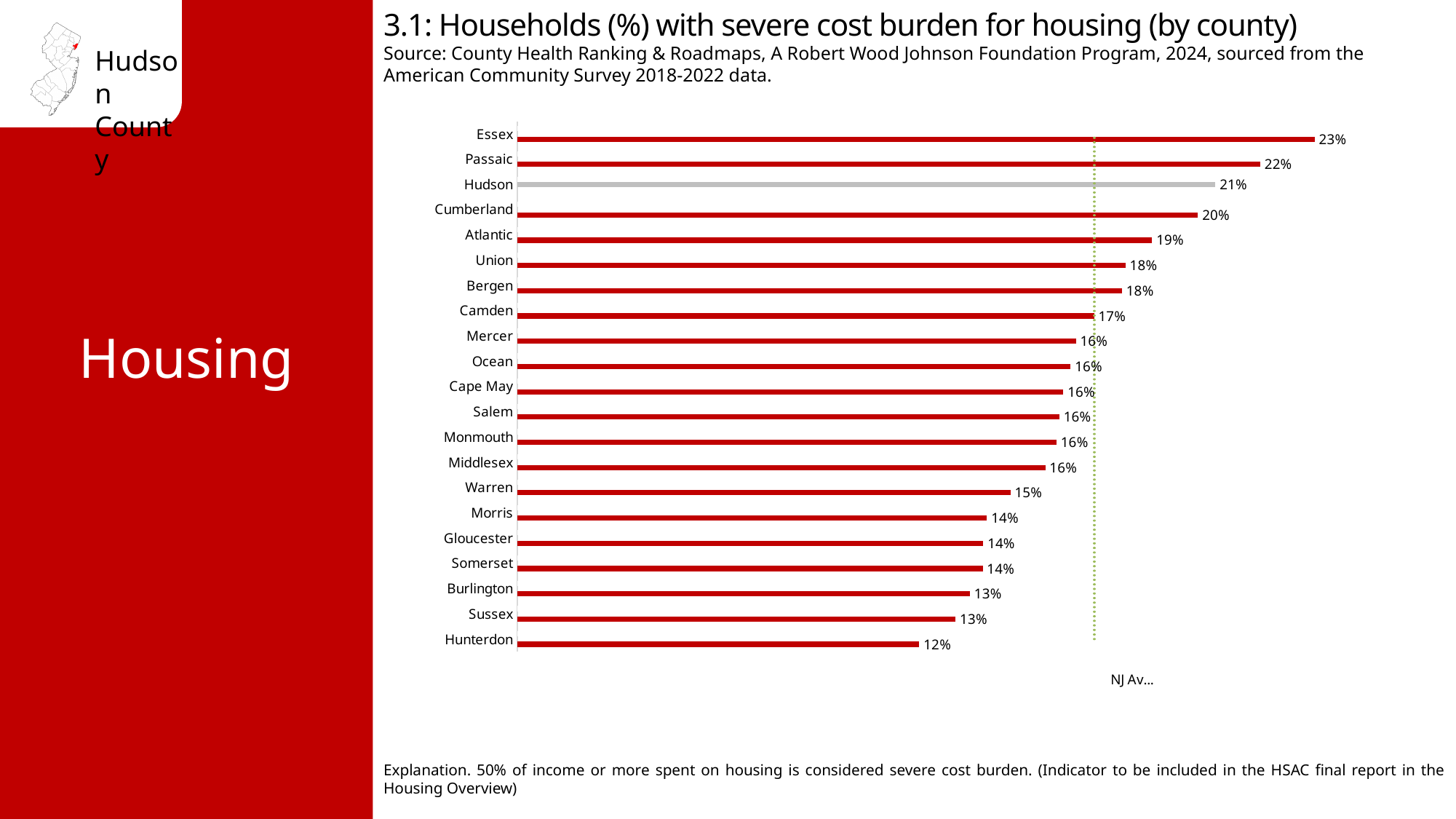
What is the difference between the values for Essex and Hunterdon? 11% Which county has the highest value? Essex Which is larger, the value for Passaic or the value for Atlantic? Passaic What is the difference between the values for Hudson and Warren? 6% Which county has the lowest value? Hunterdon What is the value for Hunterdon? 12% Which county's bar is shown in grey rather than red? Hudson What is the value for Essex? 23% What kind of chart is shown on the slide? Bar chart How many counties are shown in the chart? 21 What is the value for Hudson? 21% What is the value for Cumberland? 20%